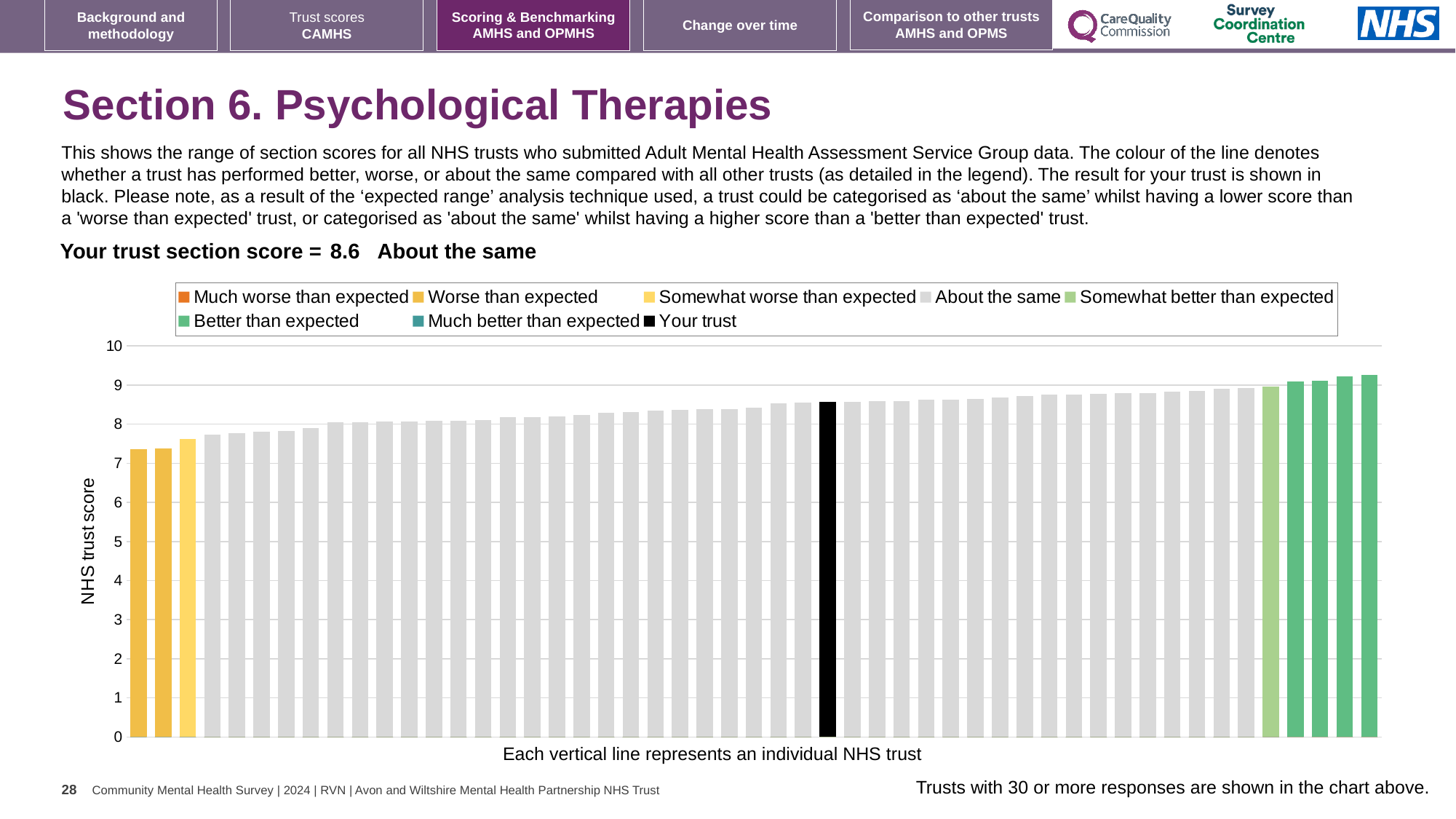
What category is your trust's section score placed in, according to the text above the chart? About the same Is the value of the rightmost bar greater or less than 9? greater What kind of chart is shown on the slide? bar chart How many bars are coloured in the 'Worse than expected' colour? 2 How many entries does the chart legend list? 8 Is the value of the leftmost bar greater or less than 8? less Is the value of the black 'Your trust' bar greater or less than 8? greater What is the label on the vertical axis of the chart? NHS trust score How many bars are coloured in the 'Better than expected' colour? 4 Do the bar values rise or fall from left to right along the x axis? rise What is the section score for your trust shown on the slide? 8.6